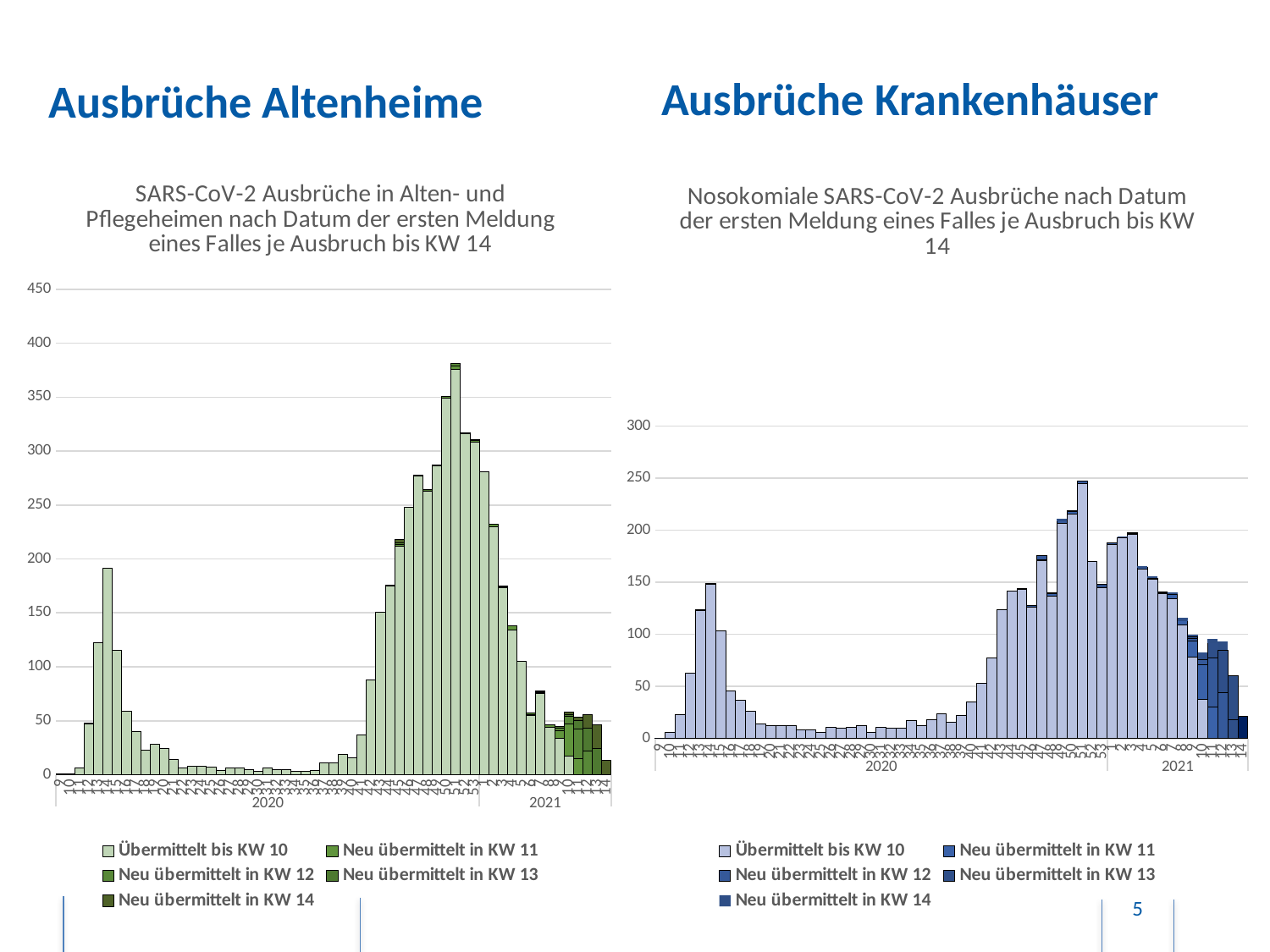
How many series does the legend of the left chart (Altenheime) list? 5 In the right chart (Krankenhäuser), is the value of the tallest bar greater or less than 200? greater In the left chart (Altenheime), is the value of the tallest bar greater or less than 350? greater Which chart has the taller peak bar, the left chart (Altenheime) or the right chart (Krankenhäuser)? The left chart (Altenheime) How many series does the legend of the right chart (Krankenhäuser) list? 5 What kind of chart is the left chart, 'SARS-CoV-2 Ausbrüche in Alten- und Pflegeheimen nach Datum der ersten Meldung eines Falles je Ausbruch bis KW 14'? Stacked bar chart Which legend entry in the right chart (Krankenhäuser) is shown in the lightest blue? Übermittelt bis KW 10 Which two years are labelled on the x axis of the left chart (Altenheime)? 2020 and 2021 What kind of chart is the right chart, 'Nosokomiale SARS-CoV-2 Ausbrüche nach Datum der ersten Meldung eines Falles je Ausbruch bis KW 14'? Stacked bar chart In the right chart (Krankenhäuser), is the value of the tallest bar greater or less than 300? less What is the highest value shown on the y axis of the left chart (Altenheime)? 450